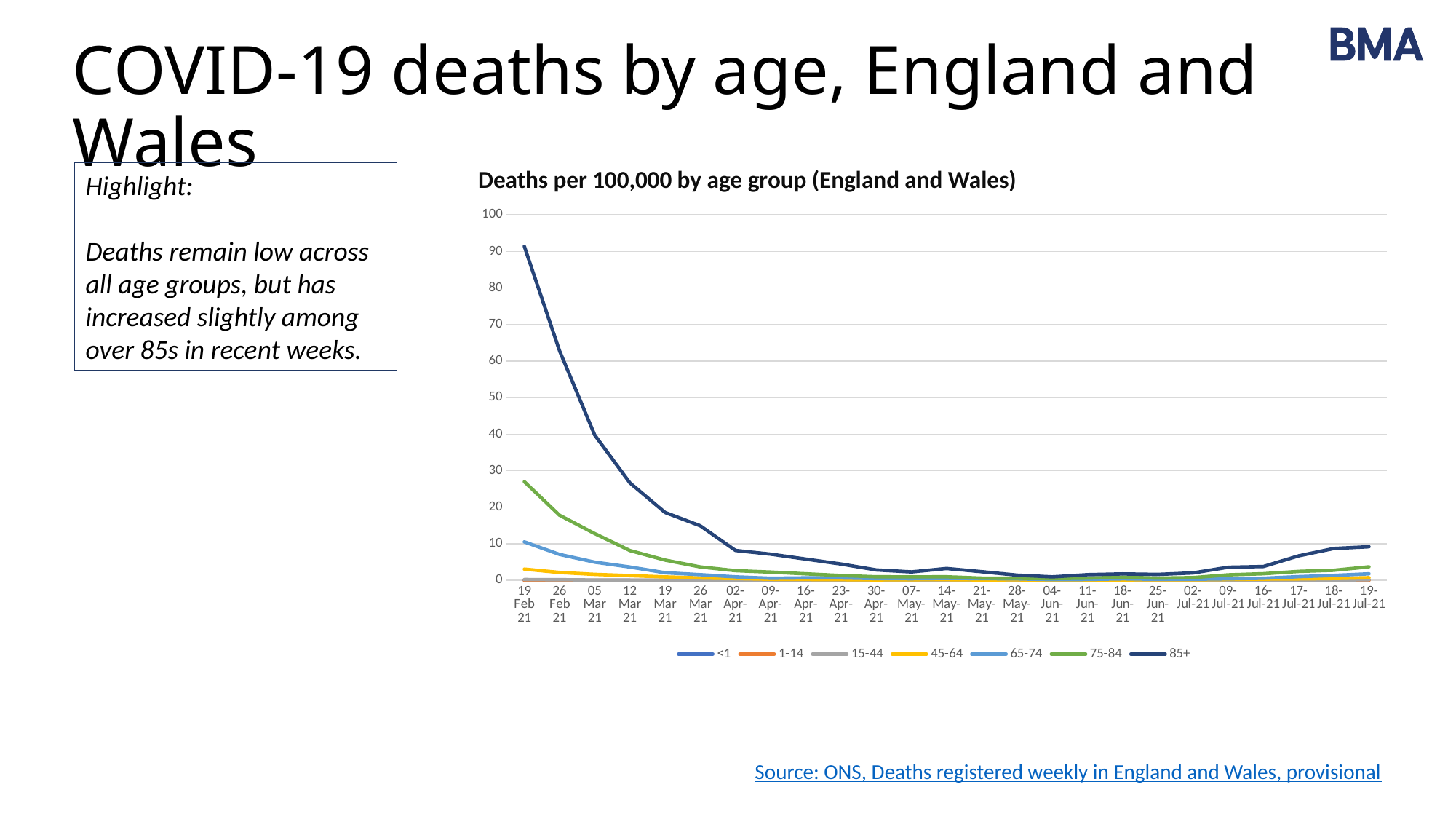
What kind of chart is shown on the slide? line chart Is the value for the 65-74 group on 19 Feb 21 greater or less than 20? less Which is larger on 19 Feb 21: the value for 85+ or the value for 75-84? 85+ Is the value for the 85+ group on 19-Jul-21 greater or less than 5? greater Is the value for the 75-84 group on 19 Feb 21 greater or less than 20? greater What is the title of the chart? Deaths per 100,000 by age group (England and Wales) How many series does the legend list? 7 Which age group has the highest deaths per 100,000 on 19 Feb 21? 85+ Which age group is shown by the dark navy line? 85+ Does the 85+ line rise or fall between 19 Feb 21 and 04-Jun-21? fall